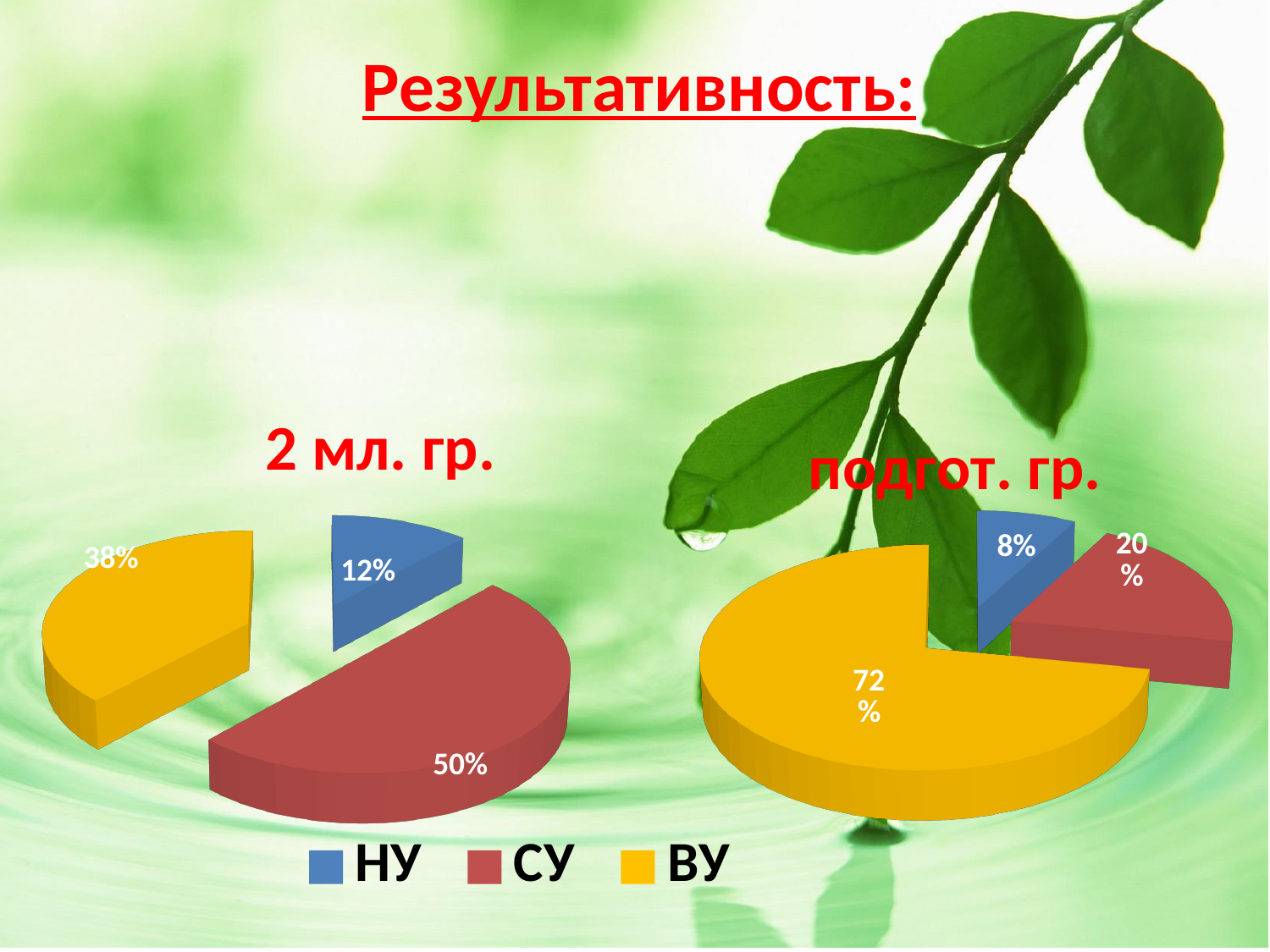
What type of chart is the "2 мл. гр." chart? Pie chart In the "2 мл. гр." chart, what is the value for СУ? 50% In the "подгот. гр." chart, what is the difference between ВУ and СУ? 52% In the "подгот. гр." chart, what is the value for НУ? 8% Which colour represents ВУ in the legend? Yellow In the "2 мл. гр." chart, what is the difference between СУ and НУ? 38% In the "подгот. гр." chart, which category has the smallest share? НУ In the "подгот. гр." chart, what is the value for ВУ? 72% In the "2 мл. гр." chart, which category has the largest share? СУ Which is larger: ВУ in the "2 мл. гр." chart or ВУ in the "подгот. гр." chart? ВУ in the "подгот. гр." chart In the "2 мл. гр." chart, what is the value for ВУ? 38% How many slices does the "подгот. гр." chart have? 3